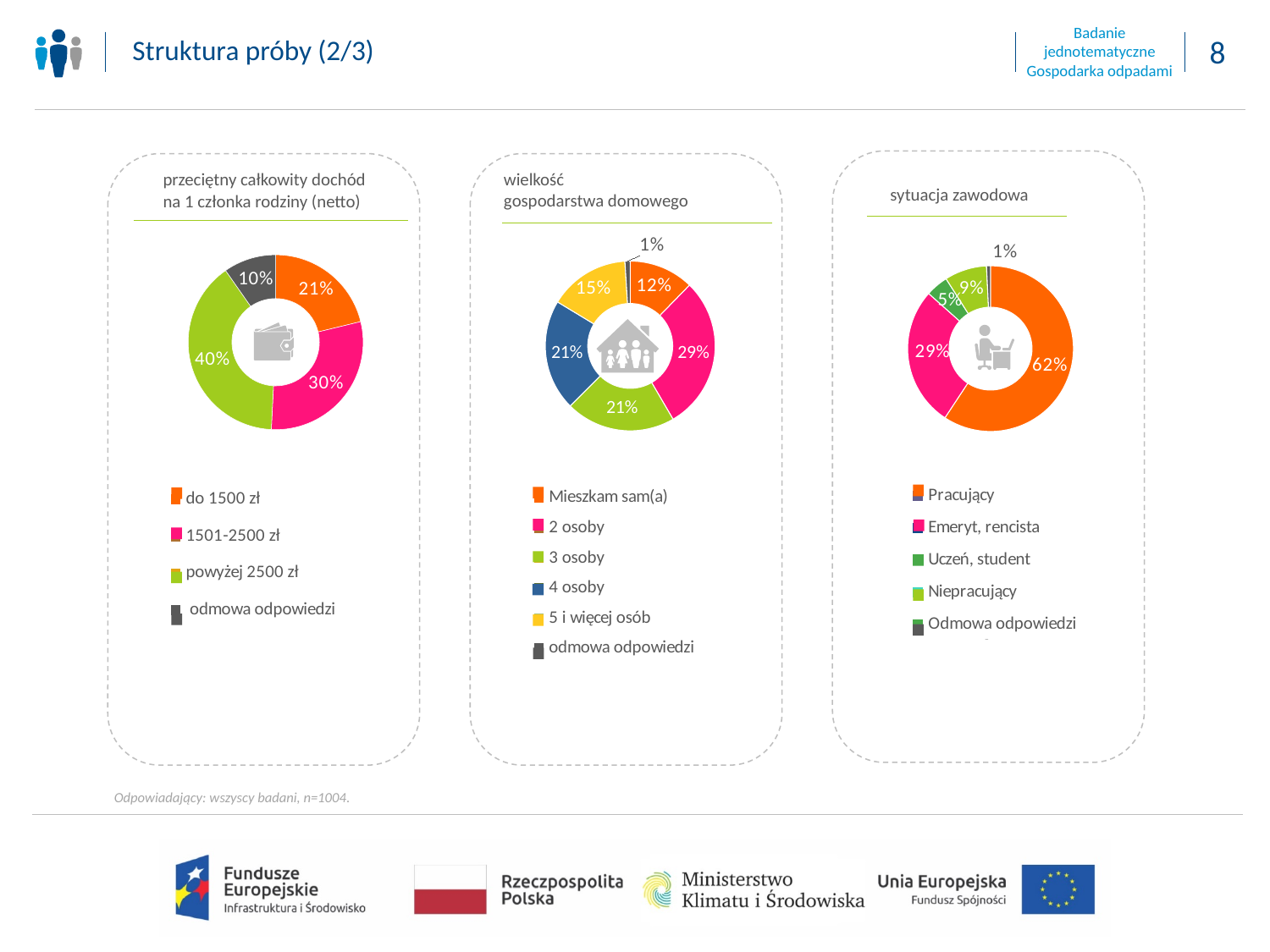
In the chart 'wielkość gospodarstwa domowego', what share is '2 osoby'? 29% In the chart 'sytuacja zawodowa', which category has the largest share? Pracujący In the chart 'wielkość gospodarstwa domowego', what share is 'Mieszkam sam(a)'? 12% What type of chart is used for 'sytuacja zawodowa'? Pie (donut) chart In the chart 'wielkość gospodarstwa domowego', which is larger: '5 i więcej osób' or '4 osoby'? 4 osoby In the chart 'sytuacja zawodowa', what share is 'Pracujący'? 62% In the chart 'przeciętny całkowity dochód na 1 członka rodziny (netto)', which category has the smallest share? odmowa odpowiedzi In the chart 'sytuacja zawodowa', what share is 'Uczeń, student'? 5% In the chart 'przeciętny całkowity dochód na 1 członka rodziny (netto)', what is the difference between '1501-2500 zł' and 'do 1500 zł'? 9% In the chart 'sytuacja zawodowa', what is the difference between 'Pracujący' and 'Emeryt, rencista'? 33% In the chart 'przeciętny całkowity dochód na 1 członka rodziny (netto)', what share is 'powyżej 2500 zł'? 40% In the chart 'wielkość gospodarstwa domowego', how many categories does the legend list? 6